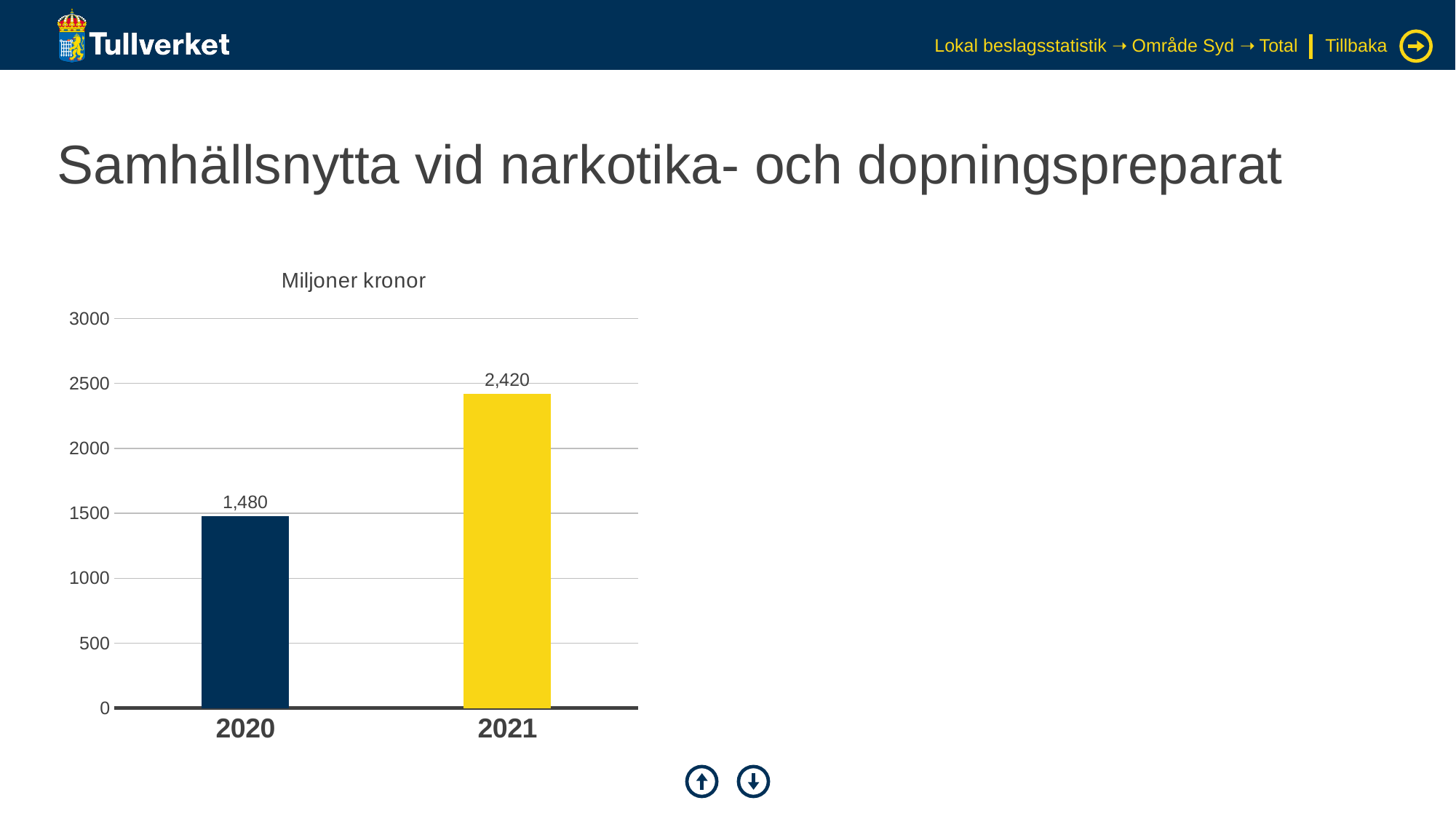
How many years are shown on the x axis? 2 What is the value for 2021? 2,420 Do the values rise or fall from 2020 to 2021? rise What kind of chart is shown on the slide? bar chart What is the value for 2020? 1,480 Which year has the highest value? 2021 Is the value for 2021 greater or less than 2000? greater What is the difference between the values for 2021 and 2020? 940 What unit is shown above the chart? Miljoner kronor Is the value for 2020 greater or less than 1500? less Which year has the lowest value? 2020 Which is larger, the value for 2020 or the value for 2021? 2021